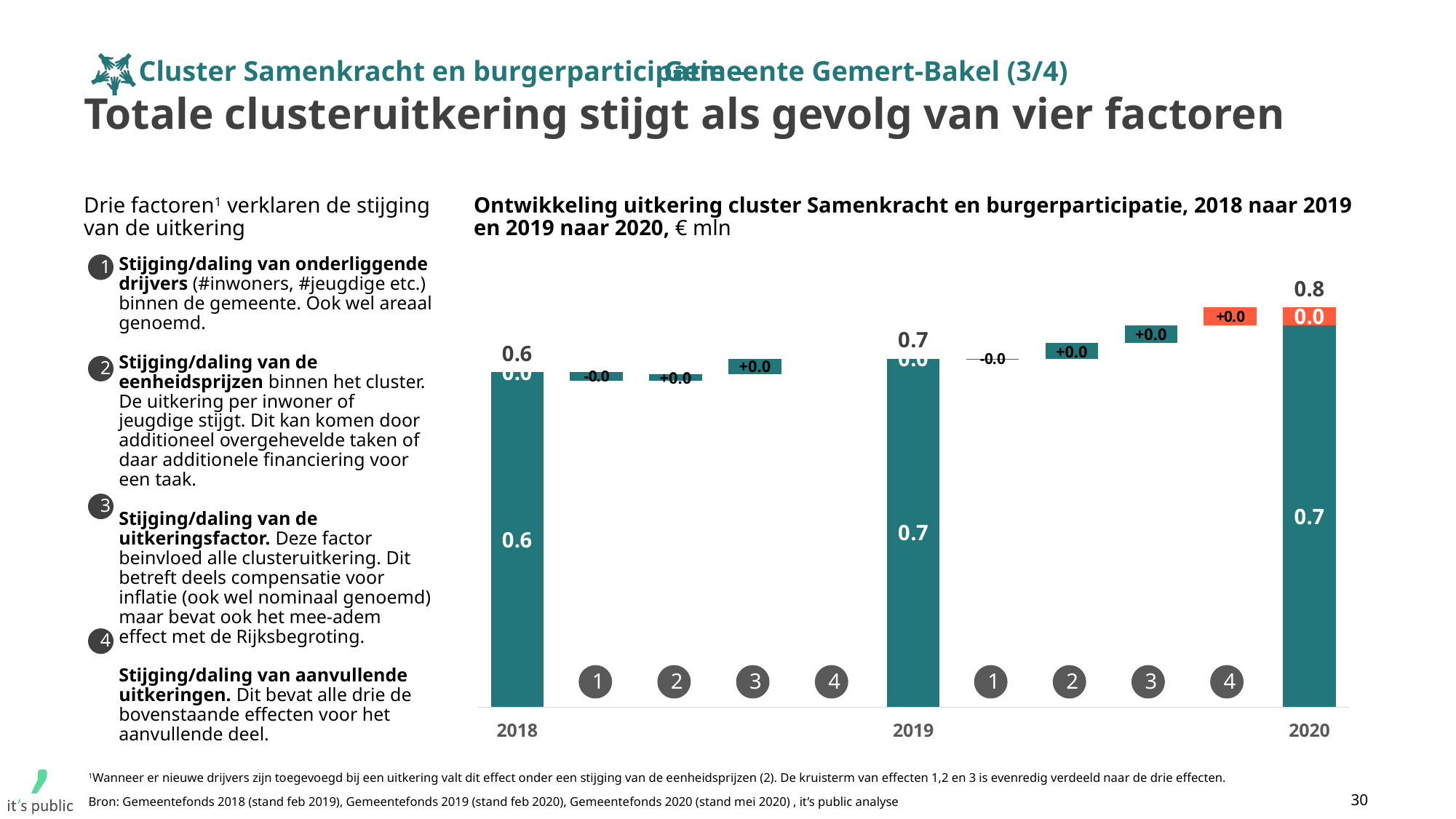
What is the difference between the 2020 total and the 2018 total? 0.2 What is the total value shown above the 2019 bar? 0.7 What is the total value shown above the 2020 bar? 0.8 Which year has the highest total uitkering in the chart? 2020 What kind of chart is shown on the slide? bar chart (waterfall) Which is larger, the total for 2019 or the total for 2018? 2019 Do the year totals rise or fall from 2018 to 2020? rise Which year has the lowest total uitkering in the chart? 2018 What is the total value shown above the 2018 bar? 0.6 What is the value label printed inside the teal part of the 2020 bar? 0.7 In what unit are the values in the chart expressed, according to the chart title? € mln How many year totals (full bars) are shown in the chart? 3